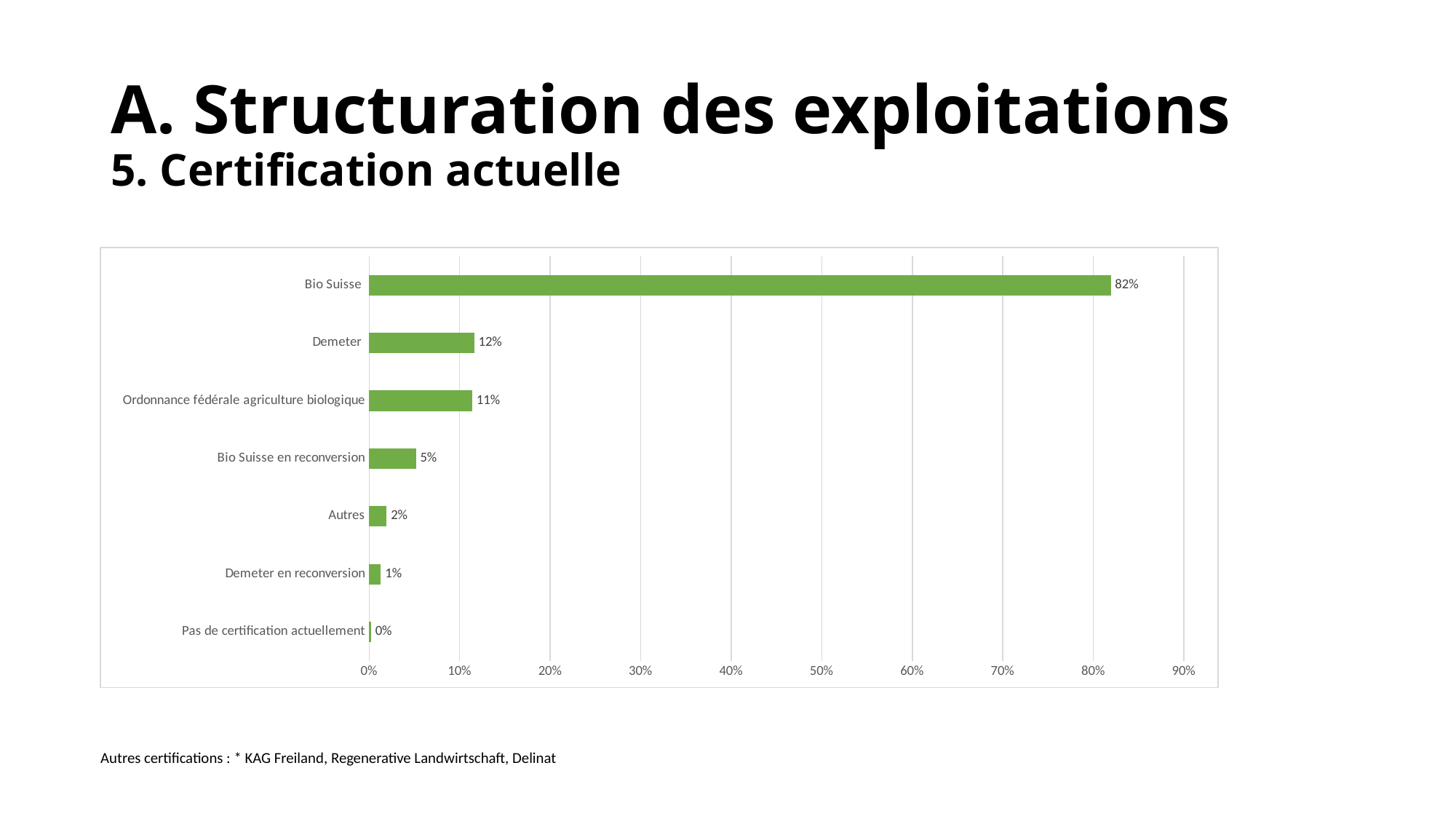
What is the value for Bio Suisse? 82% What kind of chart is shown on the slide? Bar chart What is the value for Demeter en reconversion? 1% What is the value for Demeter? 12% Which is larger, the value for Bio Suisse en reconversion or the value for Autres? Bio Suisse en reconversion What is the value for Bio Suisse en reconversion? 5% How many categories are shown in the chart? 7 What is the value for Ordonnance fédérale agriculture biologique? 11% What colour are the bars in the chart? Green Which category has the highest value? Bio Suisse Which category has the lowest value? Pas de certification actuellement What is the difference between the values for Bio Suisse and Demeter? 70%